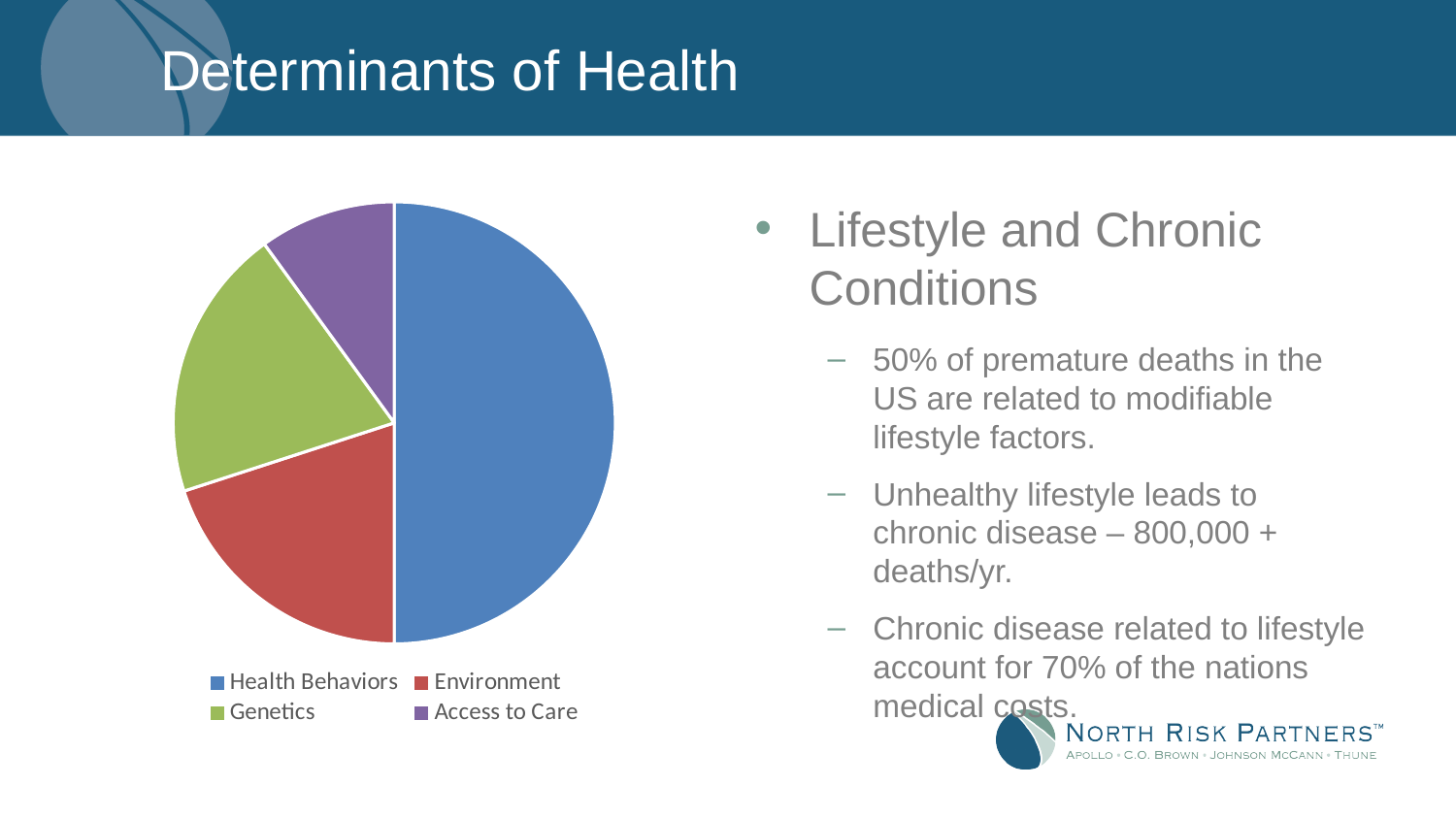
How many slices does the pie chart have? 4 What kind of chart is shown on the slide? pie chart Which category has the smallest slice of the pie chart? Access to Care Which slice is larger in the pie chart, Access to Care or Health Behaviors? Health Behaviors Which category is shown in blue in the pie chart? Health Behaviors How many entries does the pie chart's legend list? 4 Which slice is larger in the pie chart, Genetics or Access to Care? Genetics Which slice is larger in the pie chart, Health Behaviors or Environment? Health Behaviors Which category has the largest slice of the pie chart? Health Behaviors What colour is the Genetics slice in the pie chart? green